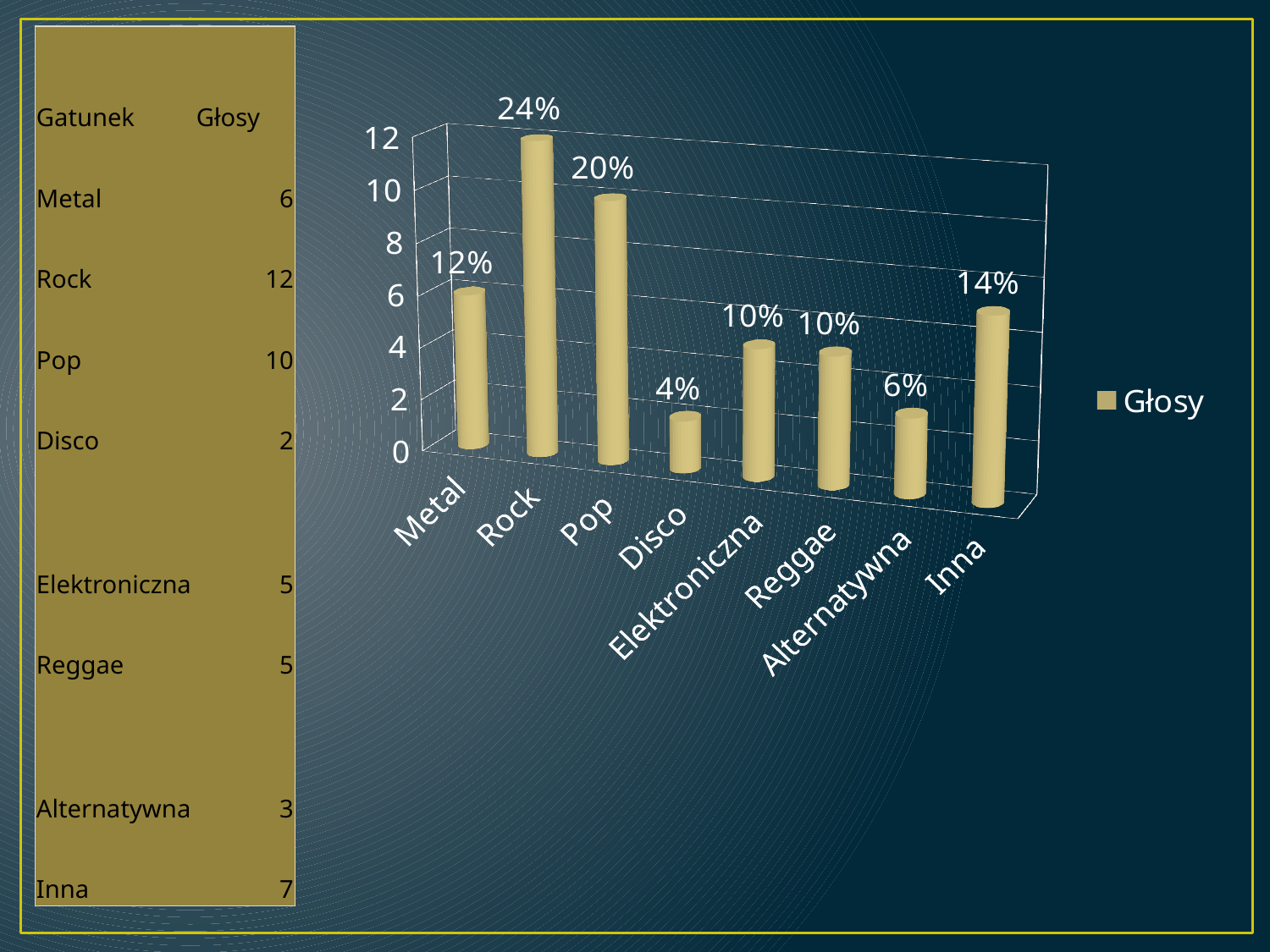
How many categories are shown on the x axis of the chart? 8 Which category has the tallest bar in the chart? Rock What data label is shown on the bar for Disco? 4% Which bar is taller, Metal or Inna? Inna Which category has the shortest bar in the chart? Disco What is the difference between the data labels for Rock and Pop? 4% What data label is shown on the bar for Inna? 14% What kind of chart is shown on the slide? bar chart What data label is shown on the bar for Rock? 24% What is the name of the series shown in the legend? Głosy Is the value for Pop greater or less than 8 on the vertical axis? greater How many series does the legend list? 1